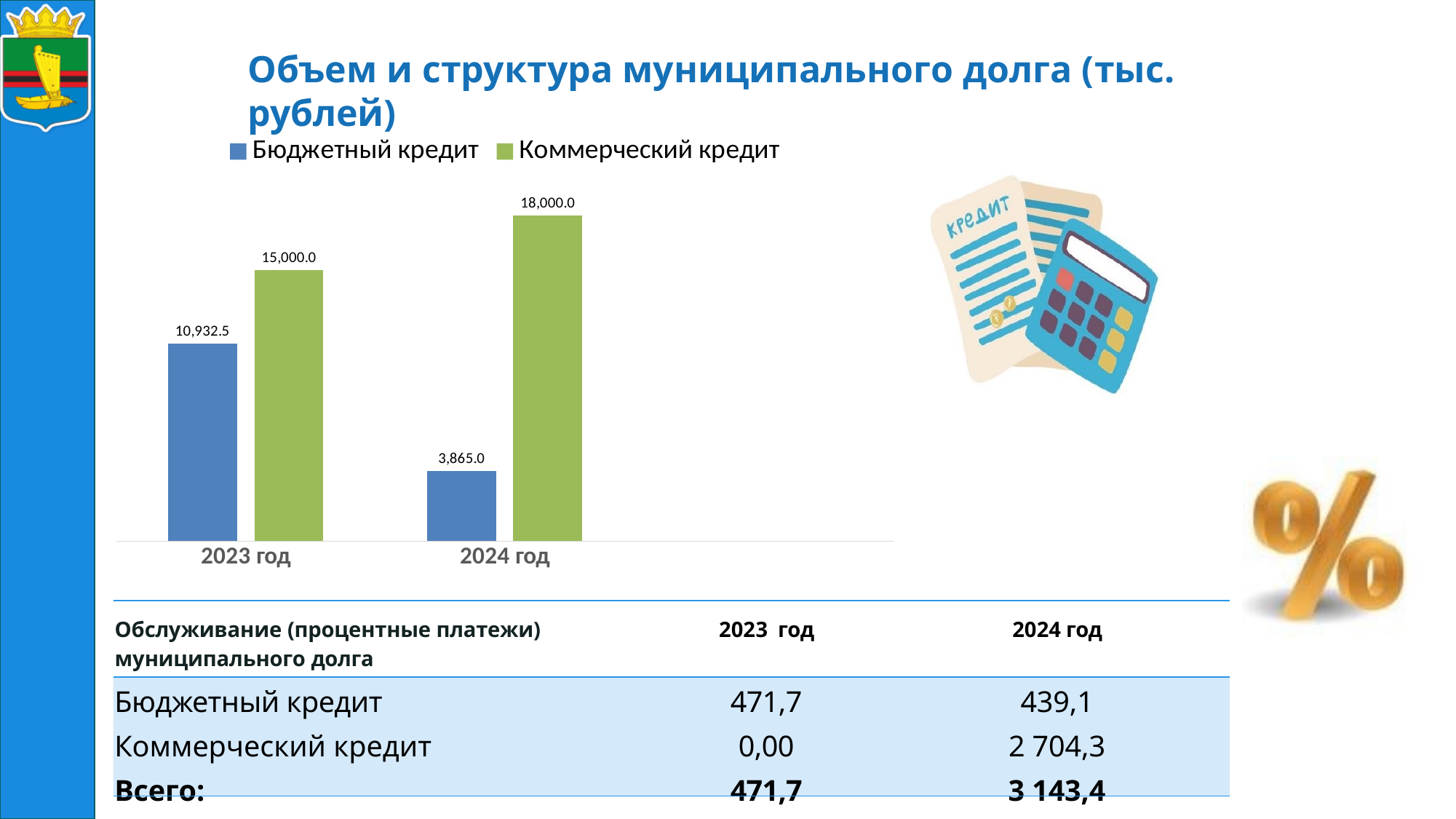
What is the value for Бюджетный кредит in 2024 год? 3,865.0 What is the difference between Бюджетный кредит in 2023 год and Бюджетный кредит in 2024 год? 7,067.5 What kind of chart is shown on the slide? Bar chart What is the value for Бюджетный кредит in 2023 год? 10,932.5 What is the value for Коммерческий кредит in 2024 год? 18,000.0 What is the difference between Коммерческий кредит in 2024 год and Коммерческий кредит in 2023 год? 3,000.0 Which is larger in 2023 год: Бюджетный кредит or Коммерческий кредит? Коммерческий кредит How many series does the legend list? 2 Which bar has the highest value on the chart? Коммерческий кредит, 2024 год Does the value for Бюджетный кредит rise or fall from 2023 год to 2024 год? Fall What is the value for Коммерческий кредит in 2023 год? 15,000.0 Which bar has the lowest value on the chart? Бюджетный кредит, 2024 год